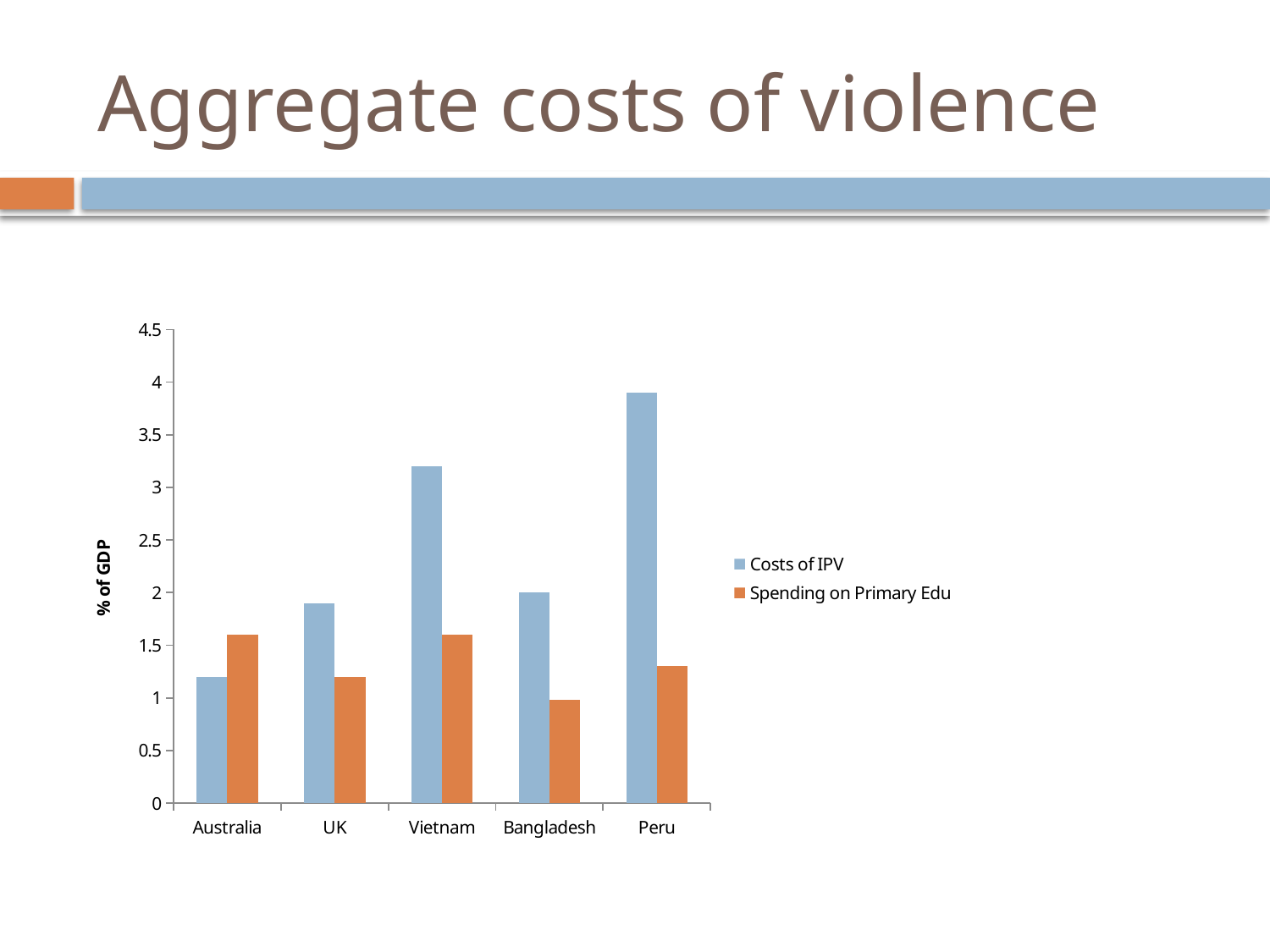
Which country has the highest value for Costs of IPV? Peru Which country has the lowest value for Spending on Primary Edu? Bangladesh How many countries are shown on the x axis of the chart? 5 Is the Spending on Primary Edu value for UK greater or less than 1.5? less Which country has the lowest value for Costs of IPV? Australia Is the Costs of IPV value for Peru greater or less than 3.5? greater What kind of chart is shown on the slide? bar chart How many series does the chart's legend list? 2 For Australia, which is larger: Costs of IPV or Spending on Primary Edu? Spending on Primary Edu Is the Costs of IPV value for Vietnam greater or less than 3? greater What is the label on the vertical axis of the chart? % of GDP For Vietnam, which is larger: Costs of IPV or Spending on Primary Edu? Costs of IPV